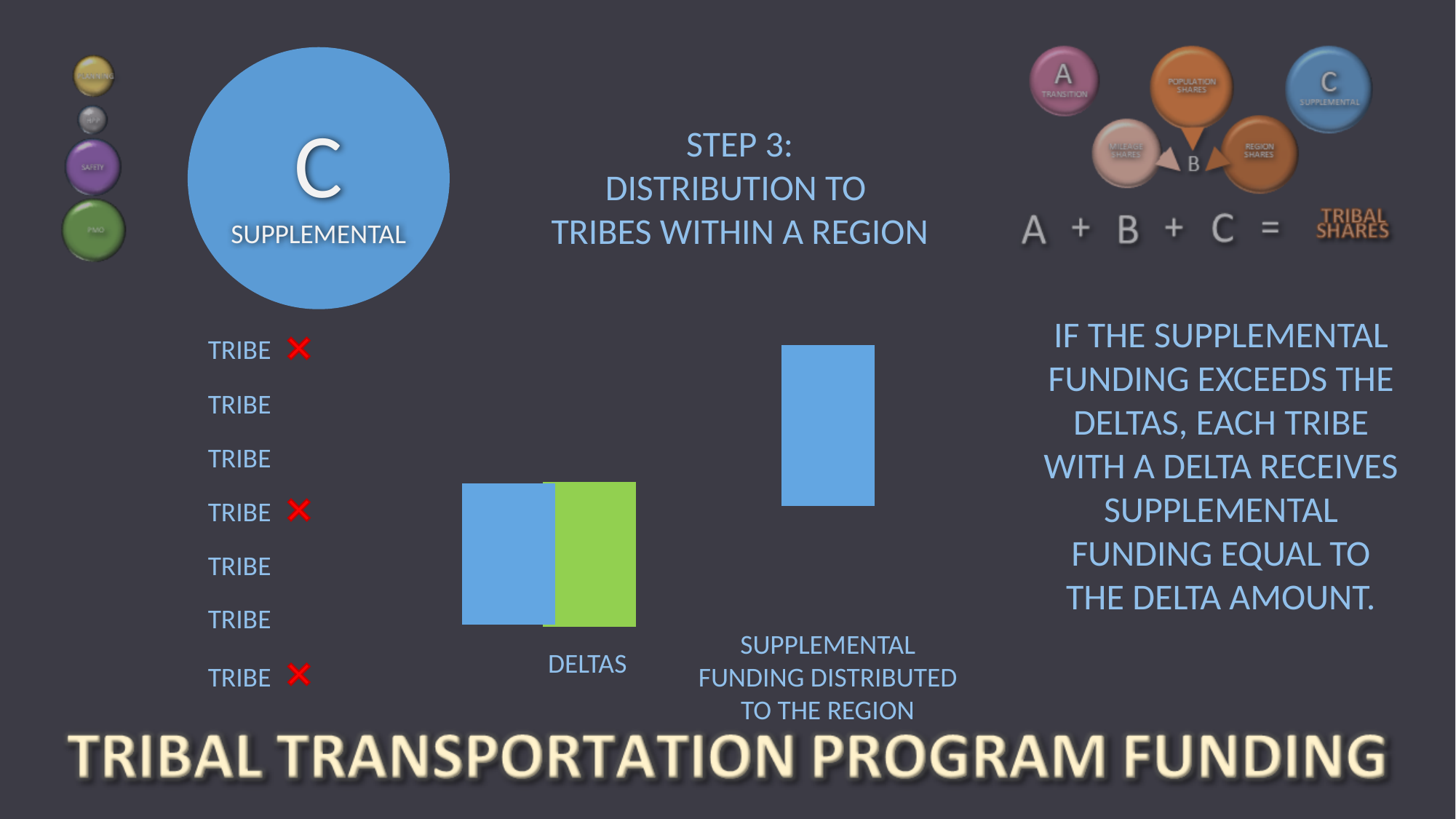
Which bar is taller: the DELTAS bar or the SUPPLEMENTAL FUNDING DISTRIBUTED TO THE REGION bar? SUPPLEMENTAL FUNDING DISTRIBUTED TO THE REGION How many of the TRIBE entries are marked with a red X? 3 How many bars are drawn in the bar diagram on the slide? 3 How many TRIBE entries are listed on the left side of the slide? 7 What label appears under the pair of blue and green bars in the middle of the slide? DELTAS What kind of chart is used to show the DELTAS and SUPPLEMENTAL FUNDING on the slide? bar chart What label appears under the single blue bar to the right of the DELTAS bars? SUPPLEMENTAL FUNDING DISTRIBUTED TO THE REGION